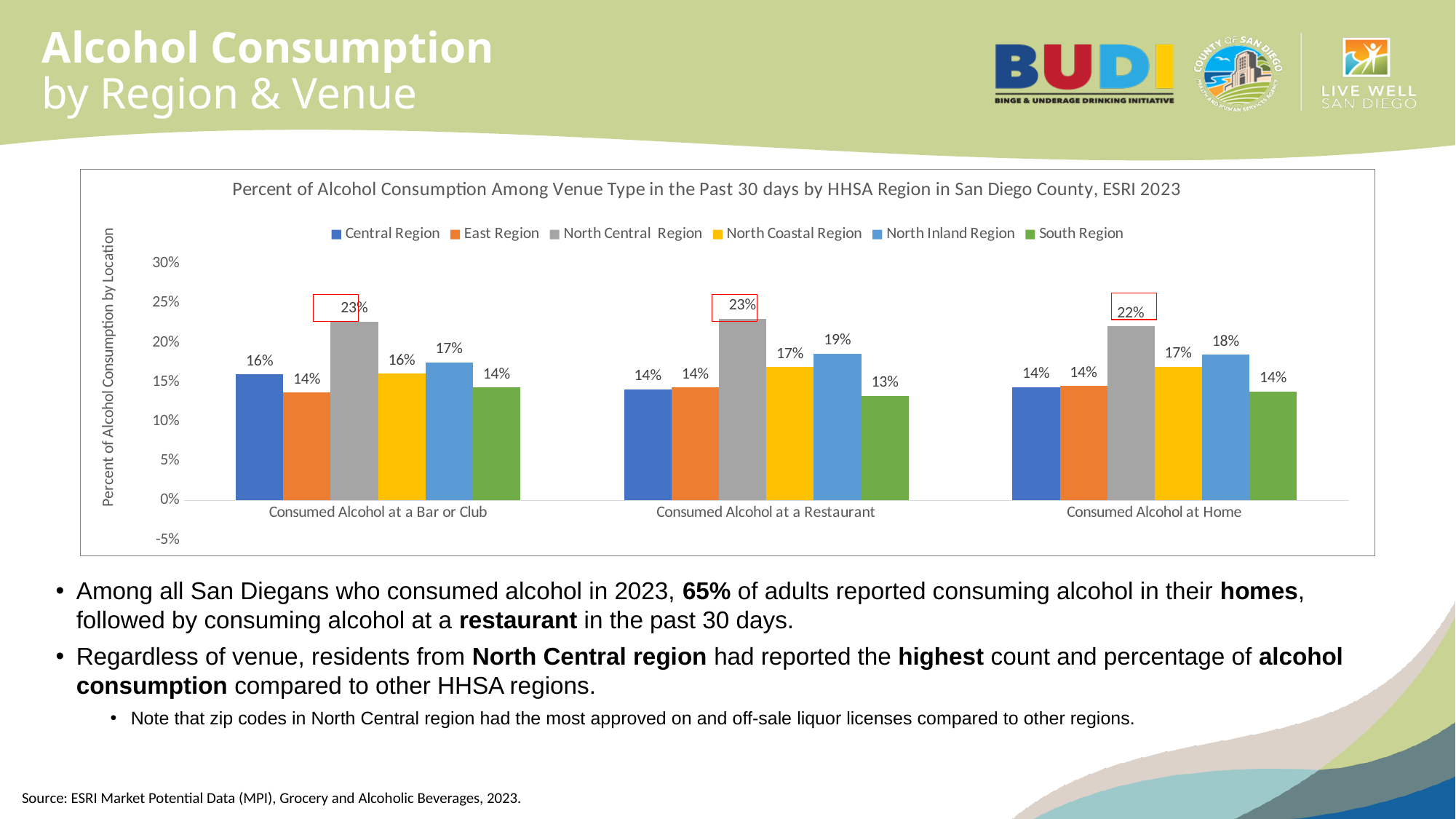
What kind of chart is shown on the slide? Bar chart What is the value for South Region for Consumed Alcohol at Home? 14% How many series does the legend list? 6 What is the value for Central Region for Consumed Alcohol at a Bar or Club? 16% How many venue categories are shown on the x axis? 3 Which is larger for Consumed Alcohol at a Restaurant: North Inland Region or North Coastal Region? North Inland Region What is the value for North Central Region for Consumed Alcohol at a Bar or Club? 23% What is the difference between the North Central Region and East Region values for Consumed Alcohol at a Bar or Club? 9% Which region has the highest value for Consumed Alcohol at Home? North Central Region What colour represents the North Central Region in the chart? Gray Which region has the lowest value for Consumed Alcohol at a Restaurant? South Region What is the value for North Inland Region for Consumed Alcohol at a Restaurant? 19%